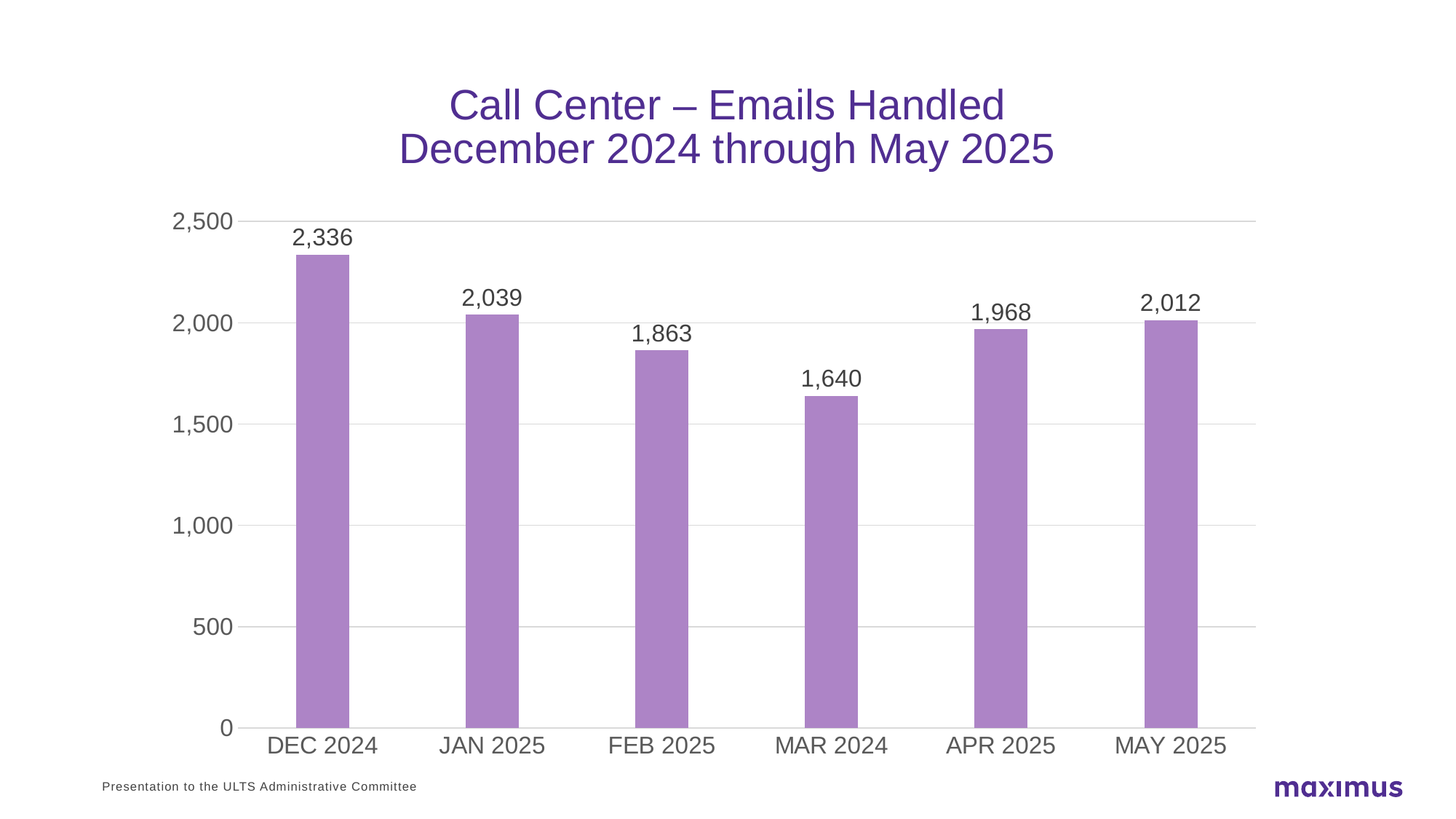
Which is larger, the value for JAN 2025 or the value for MAY 2025? JAN 2025 What is the difference between the values for FEB 2025 and MAR 2024? 223 Which month has the highest number of emails handled? DEC 2024 How many emails were handled in DEC 2024? 2,336 What is the difference between the values for DEC 2024 and JAN 2025? 297 Is the value for FEB 2025 greater or less than 2,000? less What is the value shown for MAR 2024? 1,640 How many months are shown on the x axis? 6 What is the title of the chart? Call Center – Emails Handled December 2024 through May 2025 What is the value shown for APR 2025? 1,968 Which month has the lowest number of emails handled? MAR 2024 What kind of chart is shown on the slide? bar chart